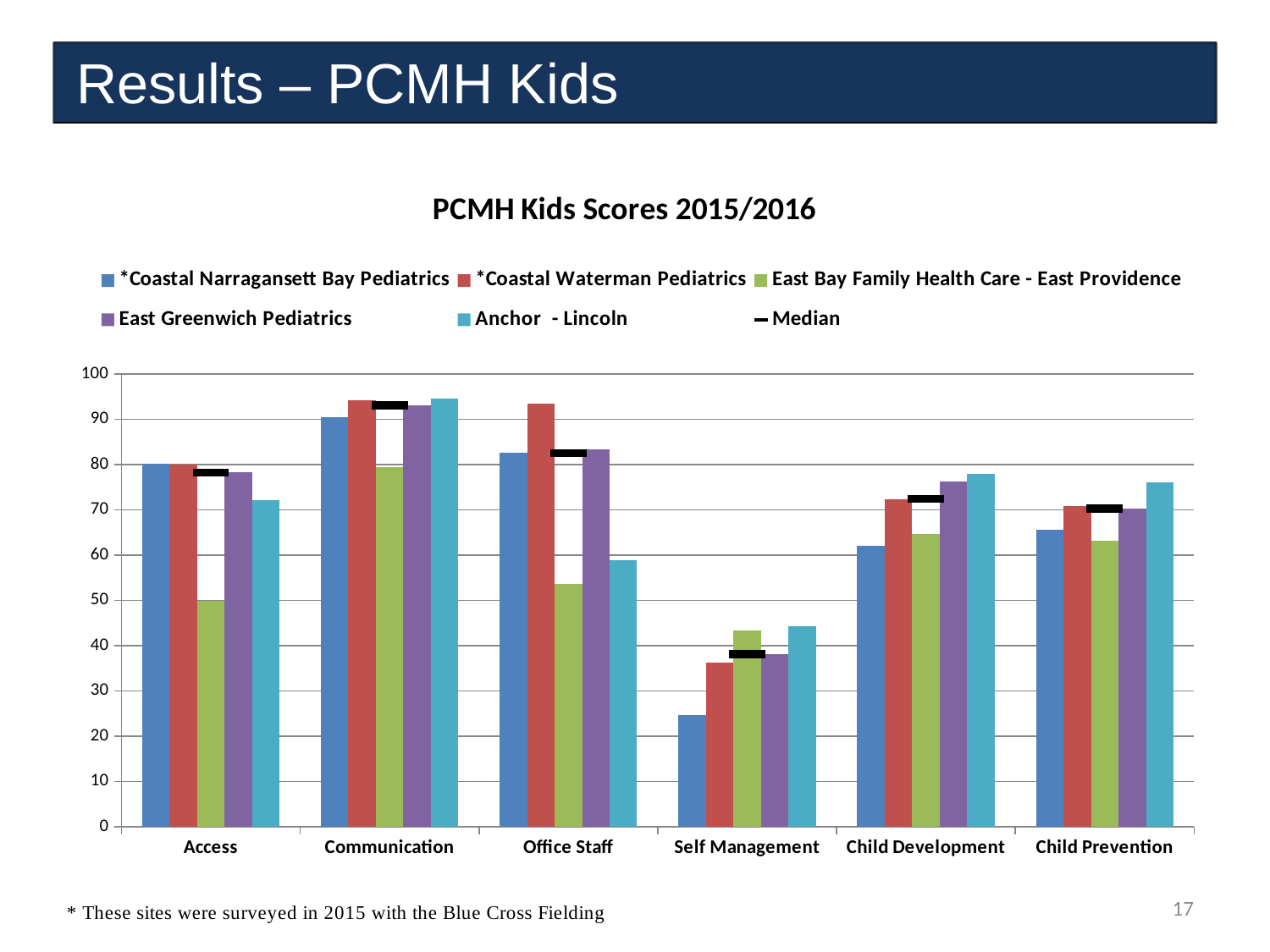
Is the Child Development score for Anchor - Lincoln greater or less than 70? greater Is the Access score for East Bay Family Health Care - East Providence greater or less than 60? less In the Self Management category, which practice has the lowest score? *Coastal Narragansett Bay Pediatrics In the Access category, which practice has the lowest score? East Bay Family Health Care - East Providence In the Communication category, which is larger: the score for *Coastal Narragansett Bay Pediatrics or for East Bay Family Health Care - East Providence? *Coastal Narragansett Bay Pediatrics What kind of chart is shown on the slide? bar chart In the Office Staff category, which practice has the highest score? *Coastal Waterman Pediatrics Which category has the lowest scores overall across the practices? Self Management How many categories are shown along the x axis? 6 What is the title of the chart? PCMH Kids Scores 2015/2016 In the Child Prevention category, which practice has the highest score? Anchor - Lincoln How many entries does the legend list? 6